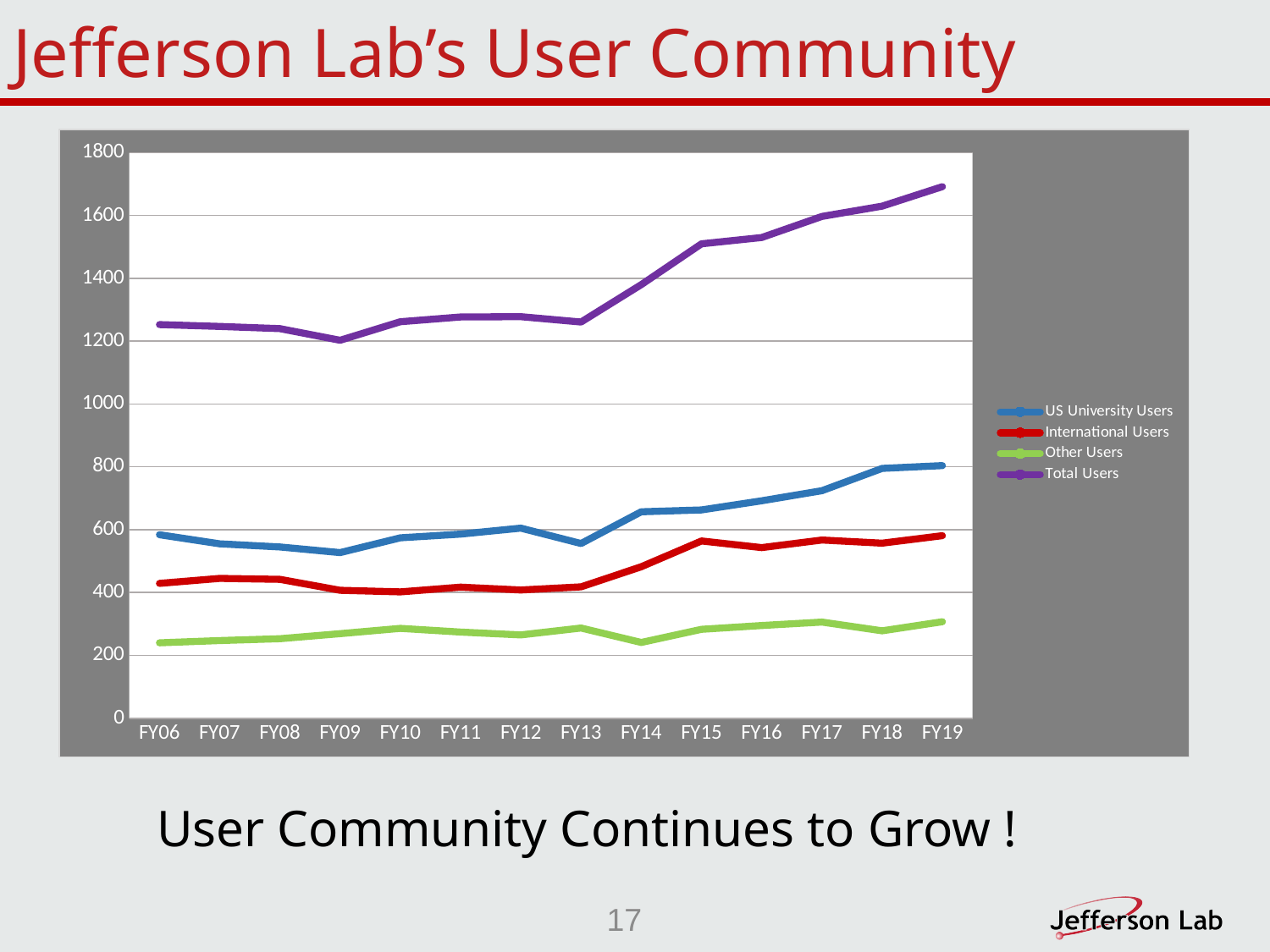
Does the Total Users line generally rise or fall from FY06 to FY19? rise In FY19, which is larger: US University Users or International Users? US University Users What kind of chart is shown on the slide? line chart Is the Total Users value for FY19 greater or less than 1600? greater In which fiscal year is the Total Users value highest? FY19 How many series does the legend list? 4 Which series is drawn with the purple line? Total Users How many fiscal years are plotted along the x axis? 14 Is the Total Users value for FY15 greater or less than 1400? greater Is the US University Users value for FY06 greater or less than 600? less In which fiscal year is the Total Users value lowest? FY09